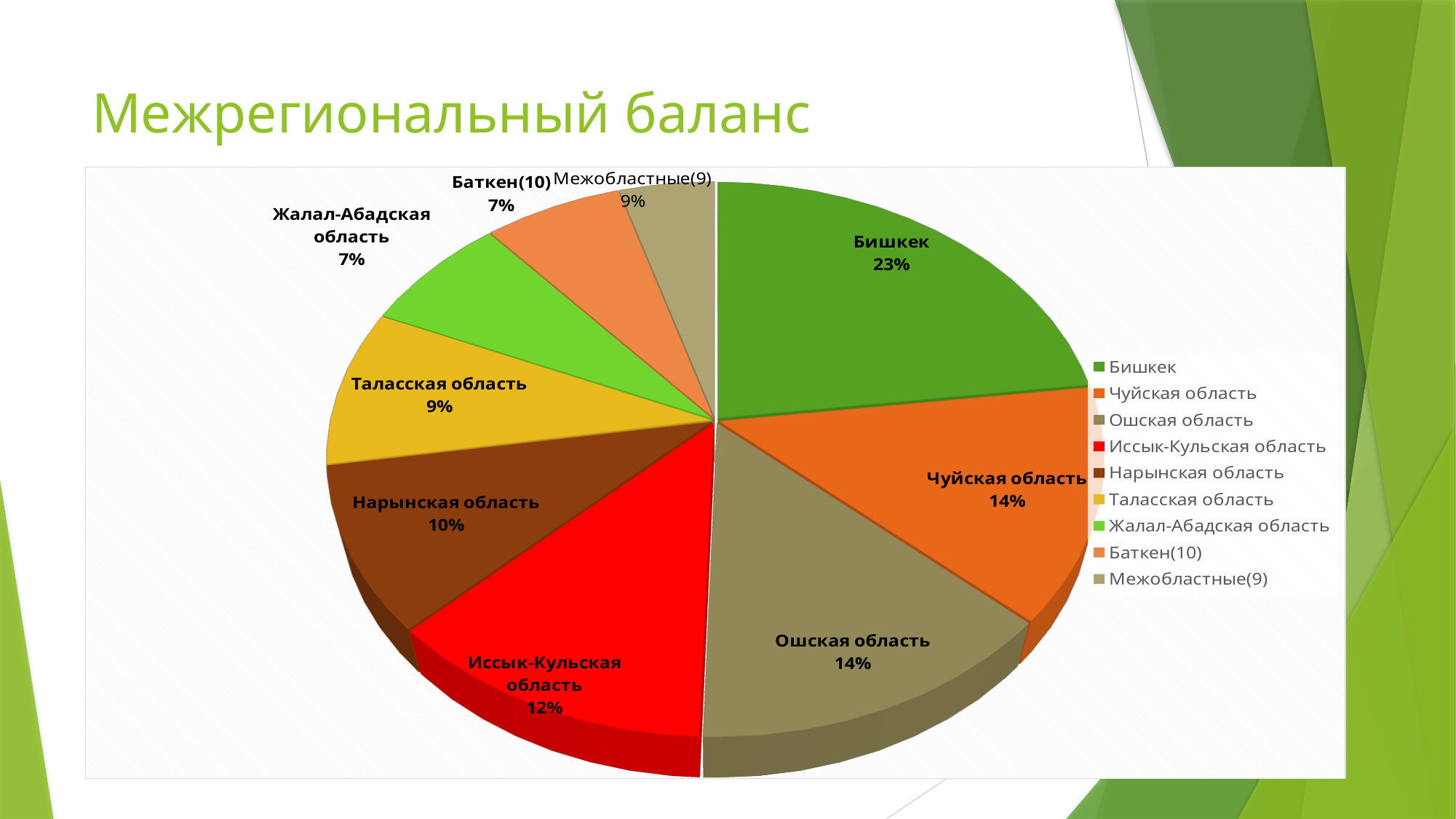
How many entries does the legend list? 9 Which is larger, the value for Таласская область or the value for Иссык-Кульская область? Иссык-Кульская область What is the difference between the values for Бишкек and Чуйская область? 9% What share of the pie does Бишкек have? 23% What colour is the slice for Иссык-Кульская область? Red What is the value shown for Иссык-Кульская область? 12% What is the value shown for Межобластные(9)? 9% Which category has the largest slice of the pie? Бишкек What is the value shown for Нарынская область? 10% What is the title of the slide containing the chart? Межрегиональный баланс What kind of chart is shown on the slide? Pie chart How many slices does the pie chart have? 9